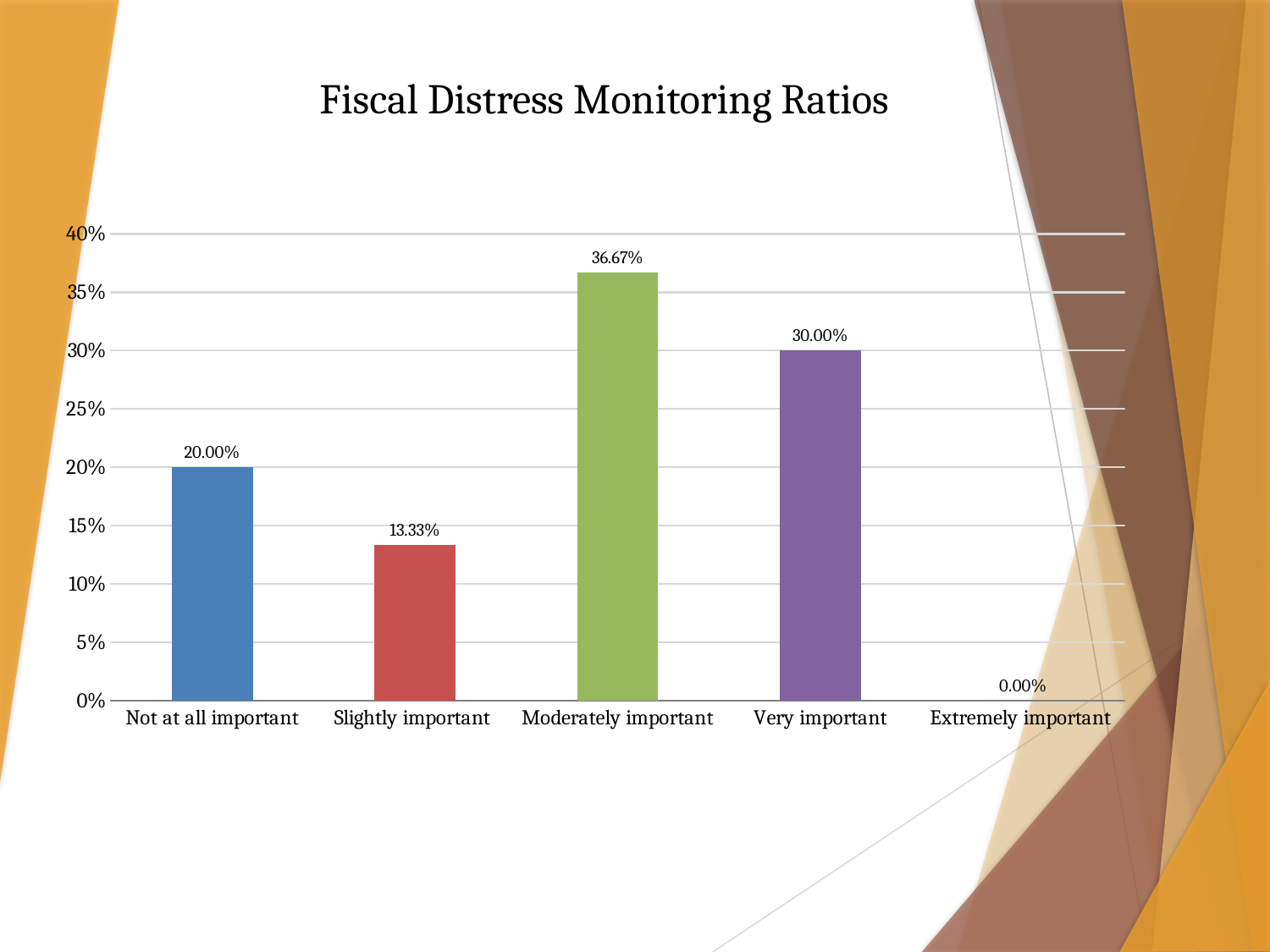
What is the value for Moderately important? 36.67% What is the title of the chart? Fiscal Distress Monitoring Ratios How many categories are shown on the x axis? 5 What is the value for Extremely important? 0.00% What is the value for Not at all important? 20.00% Which category has the highest value? Moderately important Which category has the lowest value? Extremely important Is the value for Very important greater or less than 25%? greater What is the value for Slightly important? 13.33% What kind of chart is shown on the slide? bar chart What is the difference between the values for Moderately important and Very important? 6.67% Which is larger, the value for Not at all important or the value for Slightly important? Not at all important